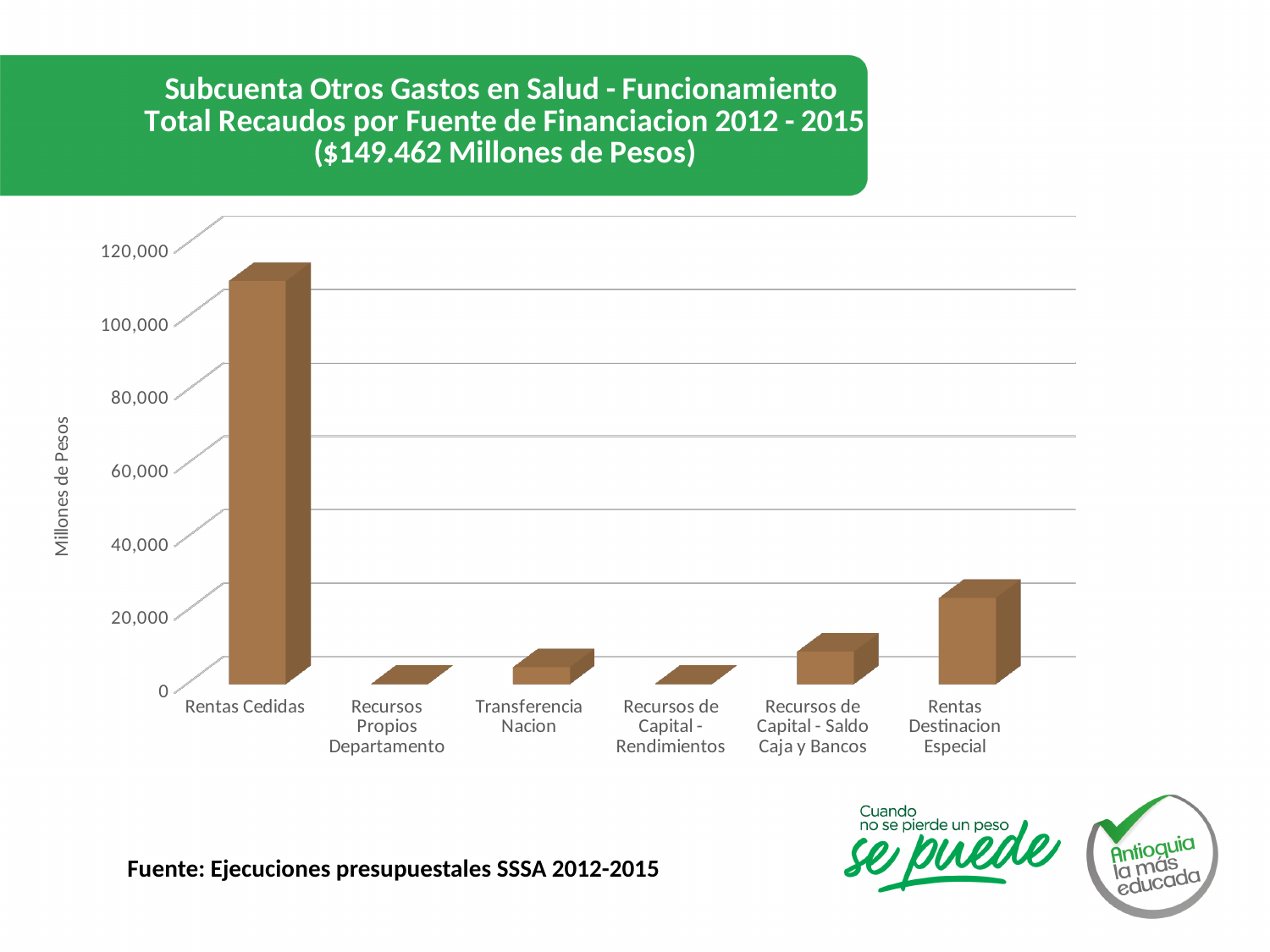
Is the value for Rentas Cedidas greater or less than 120,000? less Which is larger, the value for Transferencia Nacion or the value for Recursos de Capital - Saldo Caja y Bancos? Recursos de Capital - Saldo Caja y Bancos Which funding source has the highest value? Rentas Cedidas What is the label of the vertical axis? Millones de Pesos Which is larger, the value for Rentas Destinacion Especial or the value for Recursos de Capital - Saldo Caja y Bancos? Rentas Destinacion Especial Is the value for Rentas Cedidas greater or less than 100,000? greater Is the value for Rentas Destinacion Especial greater or less than 20,000? greater How many categories (funding sources) are shown on the x axis? 6 What total amount is stated in the chart title? $149.462 Millones de Pesos What kind of chart is shown on the slide? bar chart